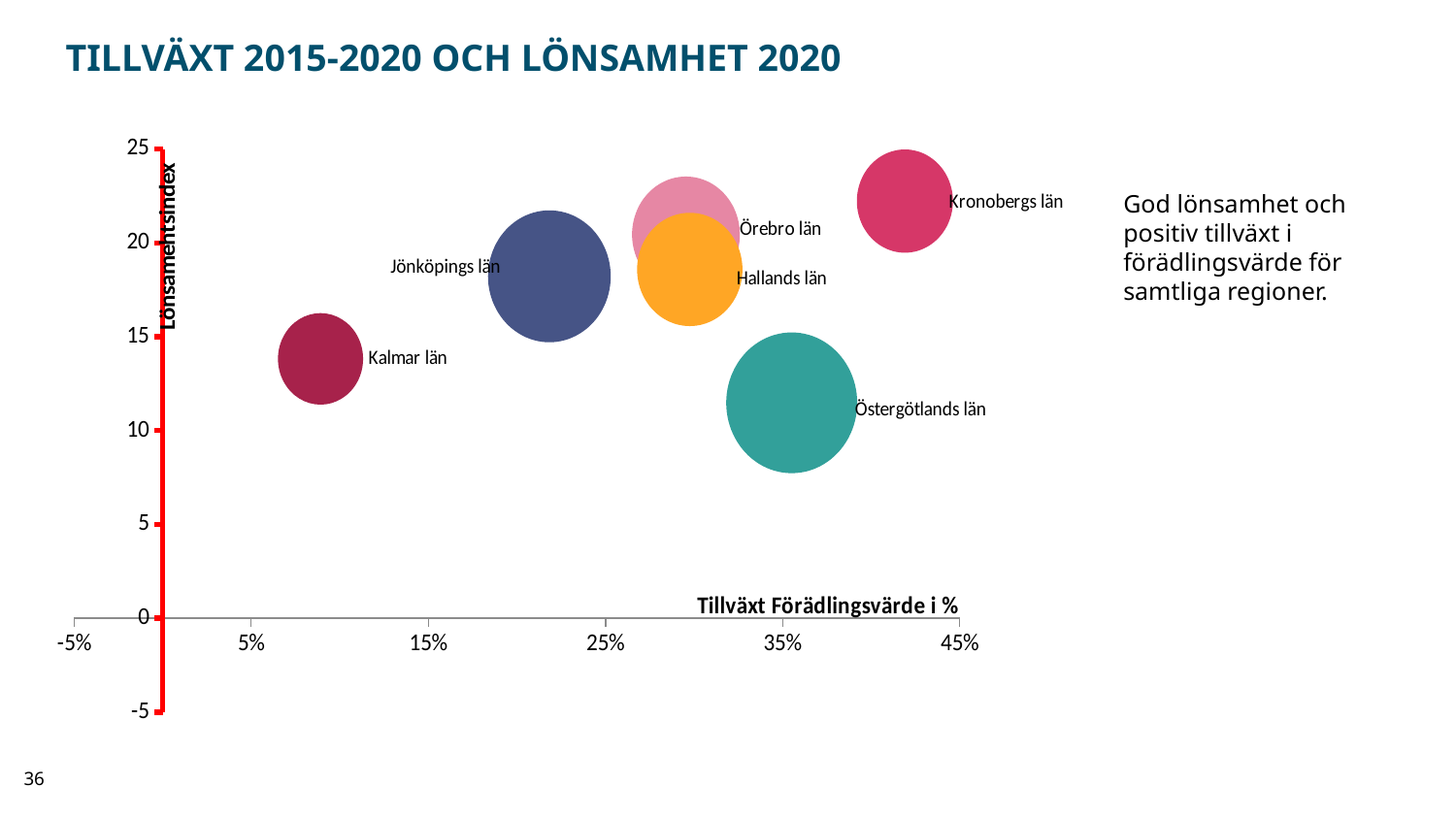
Is the growth value for Kalmar län greater or less than 15%? less Which region has the highest growth (Tillväxt Förädlingsvärde) on the horizontal axis? Kronobergs län Which region has the lowest growth (Tillväxt Förädlingsvärde) on the horizontal axis? Kalmar län What is the label of the horizontal axis? Tillväxt Förädlingsvärde i % Is the growth value for Kronobergs län greater or less than 35%? greater What is the title of the chart on the slide? TILLVÄXT 2015-2020 OCH LÖNSAMHET 2020 Which region has a higher Lönsamhetsindex, Jönköpings län or Östergötlands län? Jönköpings län What kind of chart is shown on the slide? Bubble chart Which region has the lowest Lönsamhetsindex on the vertical axis? Östergötlands län Is the Lönsamhetsindex for Östergötlands län greater or less than 15? less How many regions (bubbles) are plotted in the chart? 6